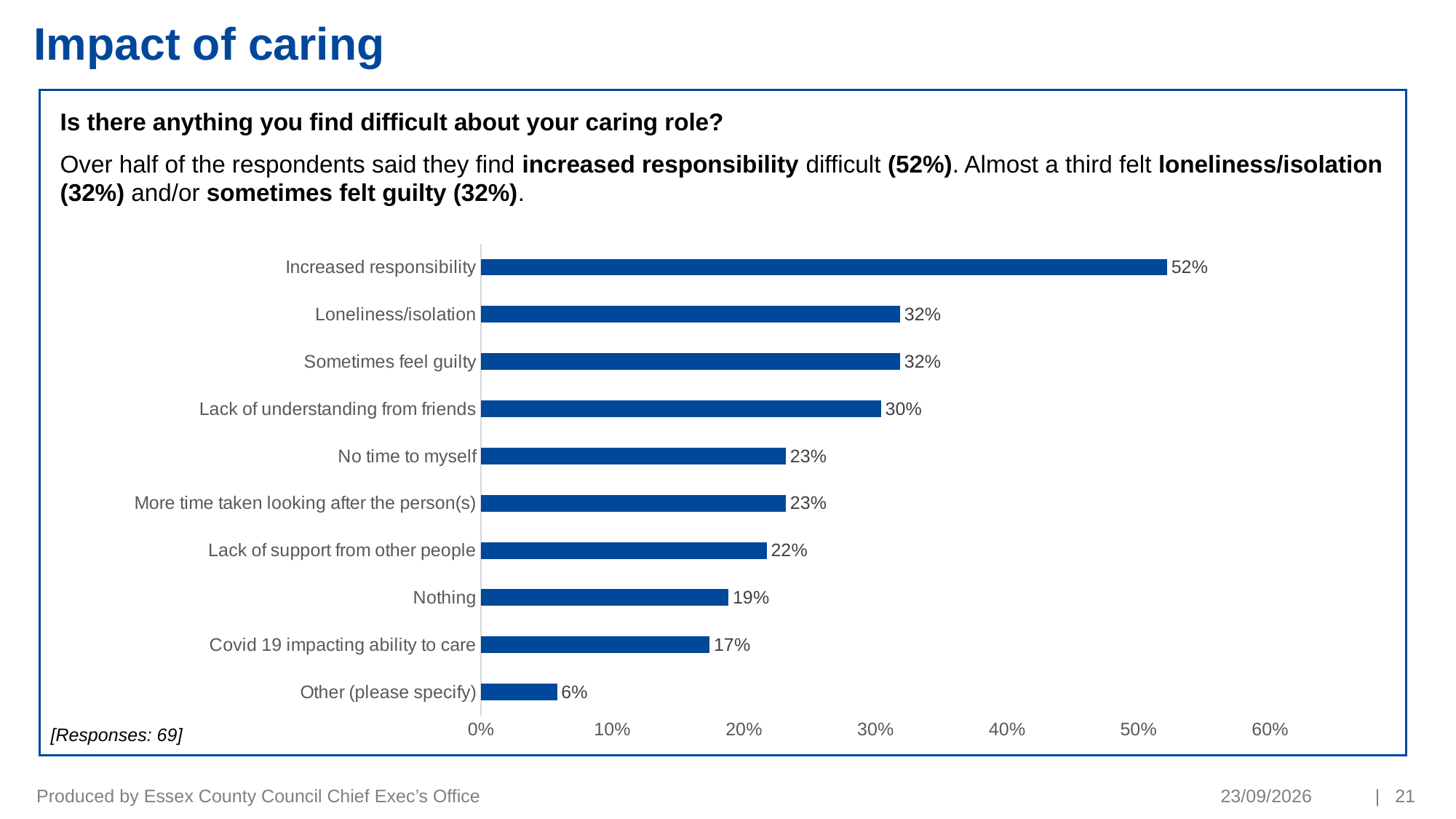
How many categories are shown in the chart? 10 Which category has the lowest value? Other (please specify) What percentage of respondents selected Covid 19 impacting ability to care? 17% How many responses does the chart note say it is based on? 69 What kind of chart is shown on the slide? Bar chart What percentage of respondents said they find increased responsibility difficult? 52% What is the value for Lack of understanding from friends? 30% Which category has the highest value? Increased responsibility What is the difference between the values for No time to myself and Other (please specify)? 17 percentage points What is the value for Nothing? 19% Which is larger, the value for Lack of support from other people or the value for Nothing? Lack of support from other people What is the difference between the values for Increased responsibility and Loneliness/isolation? 20 percentage points